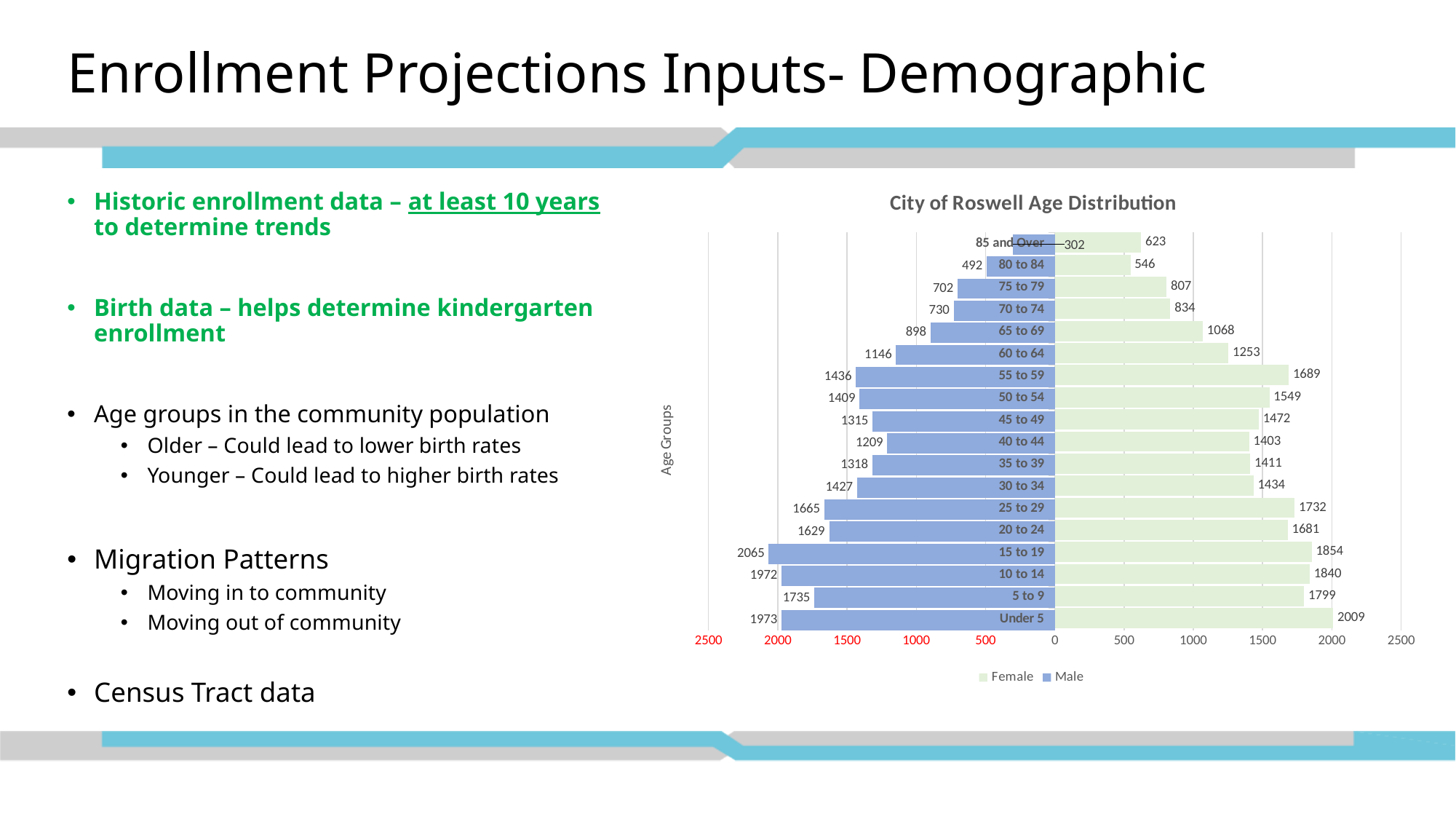
How many series does the legend list? 2 For the 55 to 59 age group, which is larger, the Male value or the Female value? Female What is the difference between the Male and Female values for the 15 to 19 age group? 211 What is the Female value for the Under 5 age group? 2009 What kind of chart is shown on the slide? Bar chart What is the title of the chart? City of Roswell Age Distribution Which age group has the highest Female value? Under 5 What is the Male value for the 15 to 19 age group? 2065 Which age group has the lowest Male value? 85 and Over How many age groups are shown on the chart? 18 Which age group has the lowest Female value? 80 to 84 What is the Male value for the 85 and Over age group? 302